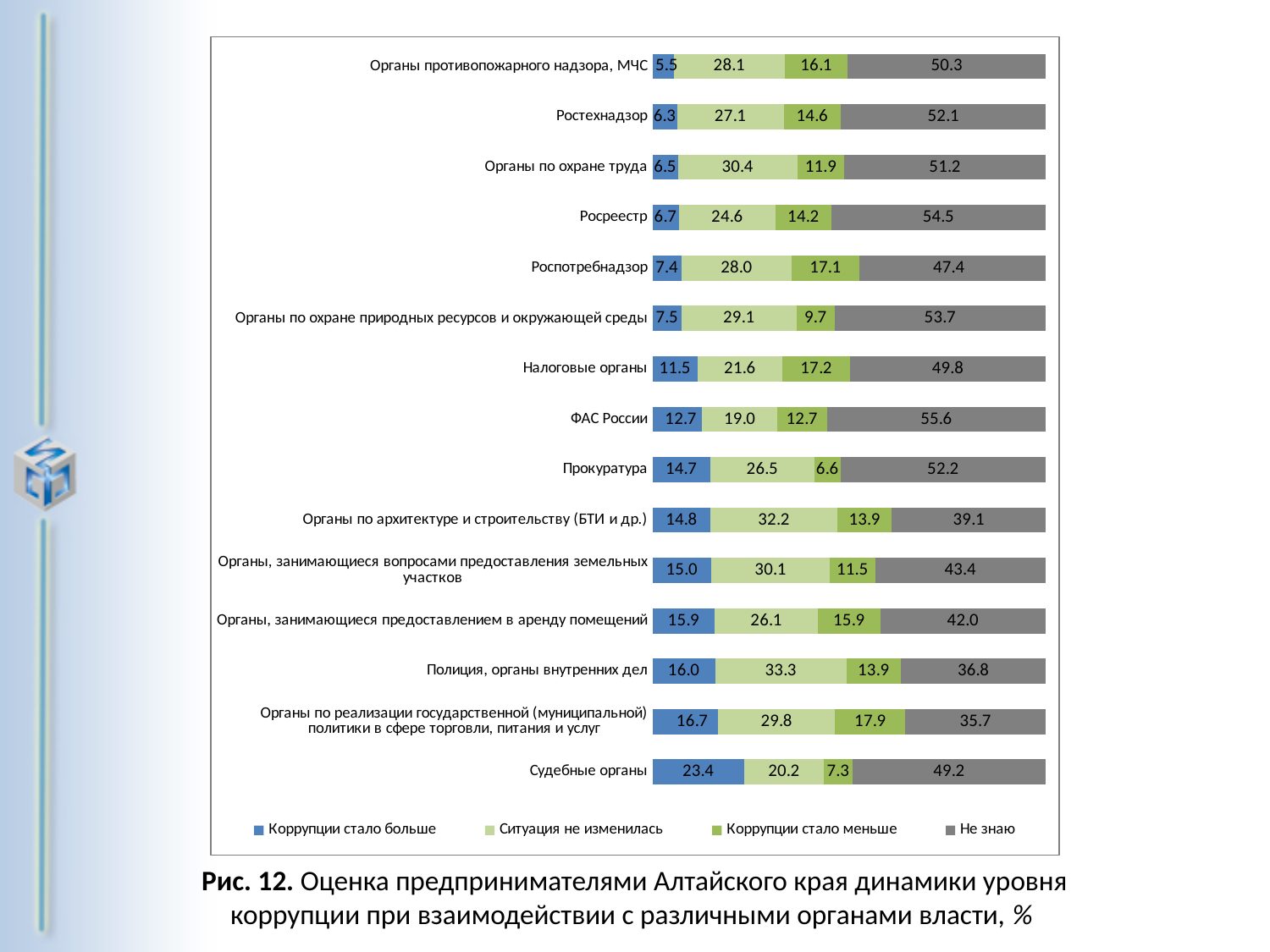
Which category has the lowest value for "Коррупции стало меньше"? Прокуратура Which series is shown in dark grey in the chart? Не знаю What is the value of "Коррупции стало больше" for Судебные органы? 23.4 Which is larger: the "Не знаю" value for Росреестр or for Роспотребнадзор? Росреестр Which category has the lowest value for "Коррупции стало больше"? Органы противопожарного надзора, МЧС What is the value of "Ситуация не изменилась" for Полиция, органы внутренних дел? 33.3 How many series does the legend list? 4 What is the value of "Не знаю" for ФАС России? 55.6 How many government bodies (categories) are shown in the chart? 15 What type of chart is shown on the slide? Stacked bar chart Which category has the highest value for "Коррупции стало больше"? Судебные органы What is the difference between the "Коррупции стало больше" values for Судебные органы and Органы противопожарного надзора, МЧС? 17.9